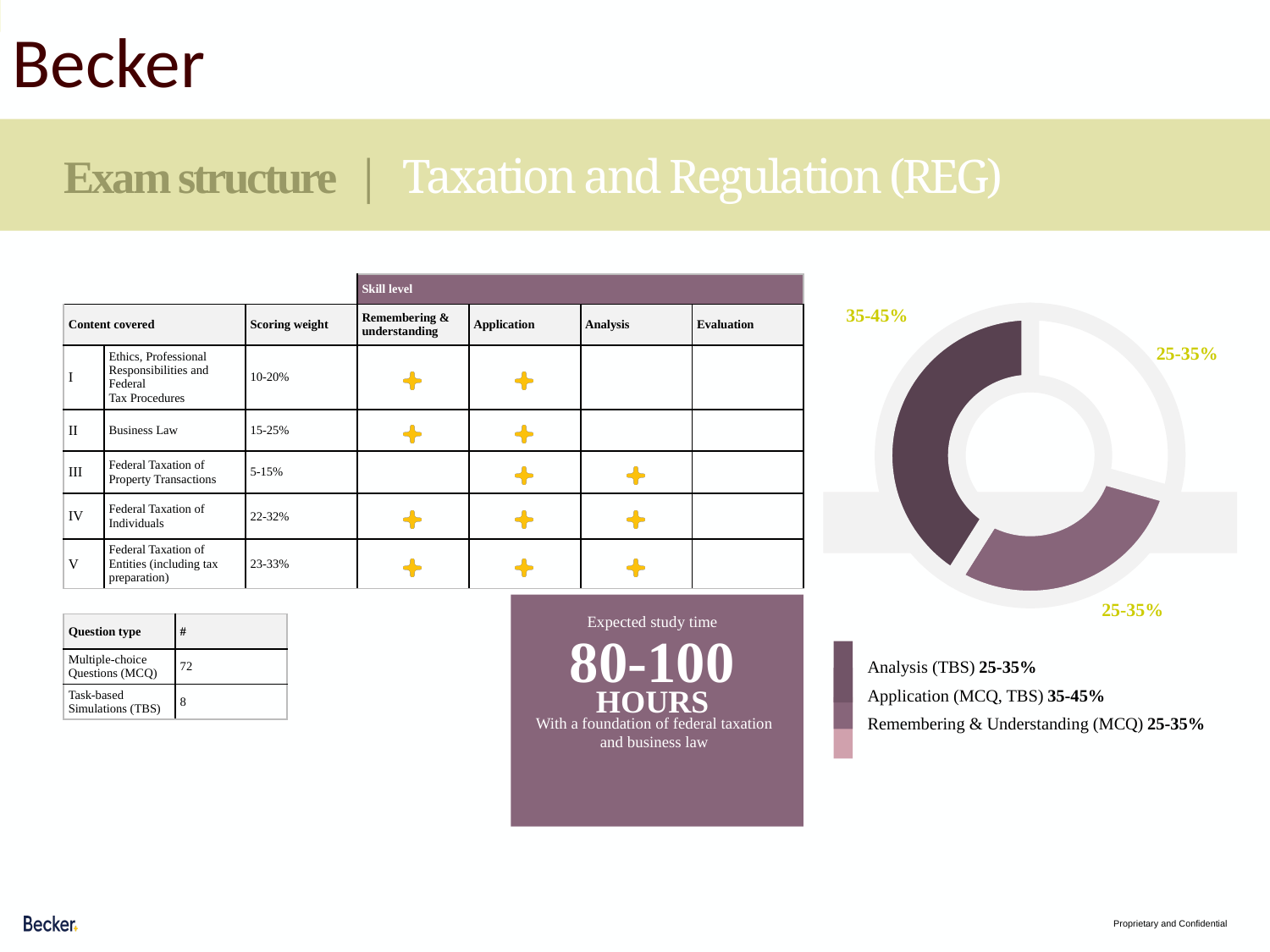
What kind of chart is shown on the right side of the slide? Doughnut chart What scoring weight is shown for Remembering & Understanding (MCQ) in the doughnut chart? 25-35% Which two skill levels in the doughnut chart share the same scoring weight of 25-35%? Analysis (TBS) and Remembering & Understanding (MCQ) What scoring weight is shown for Analysis (TBS) in the doughnut chart? 25-35% What is the largest percentage label shown on the doughnut chart? 35-45% How many slices does the doughnut chart have? 3 In the doughnut chart, which is larger: Application (MCQ, TBS) or Analysis (TBS)? Application (MCQ, TBS) Which skill level has the largest slice in the doughnut chart? Application (MCQ, TBS) How many entries does the legend of the doughnut chart list? 3 What scoring weight is shown for Application (MCQ, TBS) in the doughnut chart? 35-45%